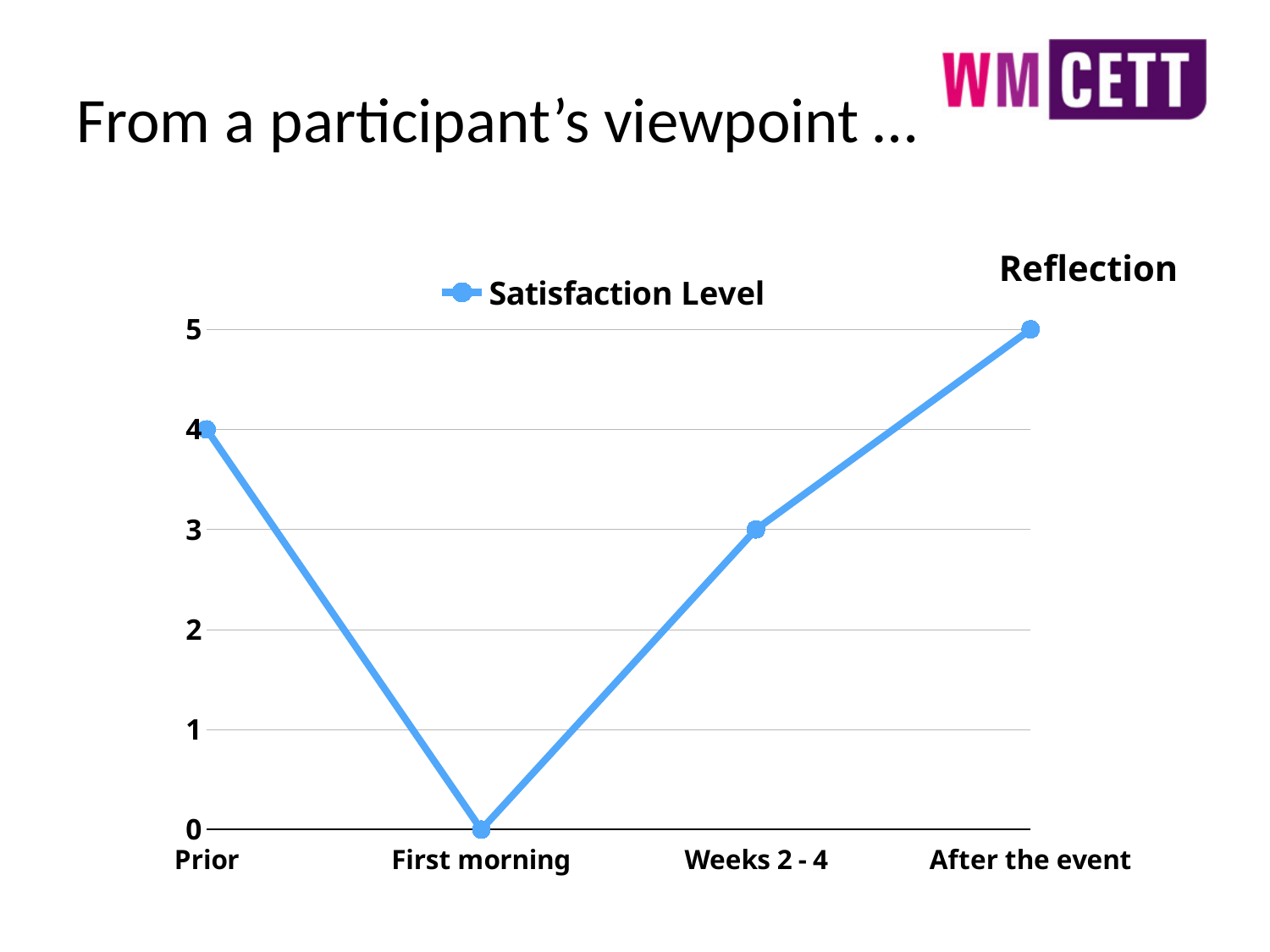
Which has a higher Satisfaction Level, Prior or Weeks 2 - 4? Prior What is the difference in Satisfaction Level between After the event and Weeks 2 - 4? 2 What is the name of the series shown in the legend? Satisfaction Level What is the Satisfaction Level at Weeks 2 - 4? 3 How many categories are plotted on the x axis? 4 Which category has the highest Satisfaction Level? After the event How many series does the legend list? 1 What type of chart is shown on the slide? Line chart Which category has the lowest Satisfaction Level? First morning What is the Satisfaction Level at After the event? 5 What is the Satisfaction Level at Prior? 4 What is the Satisfaction Level at First morning? 0